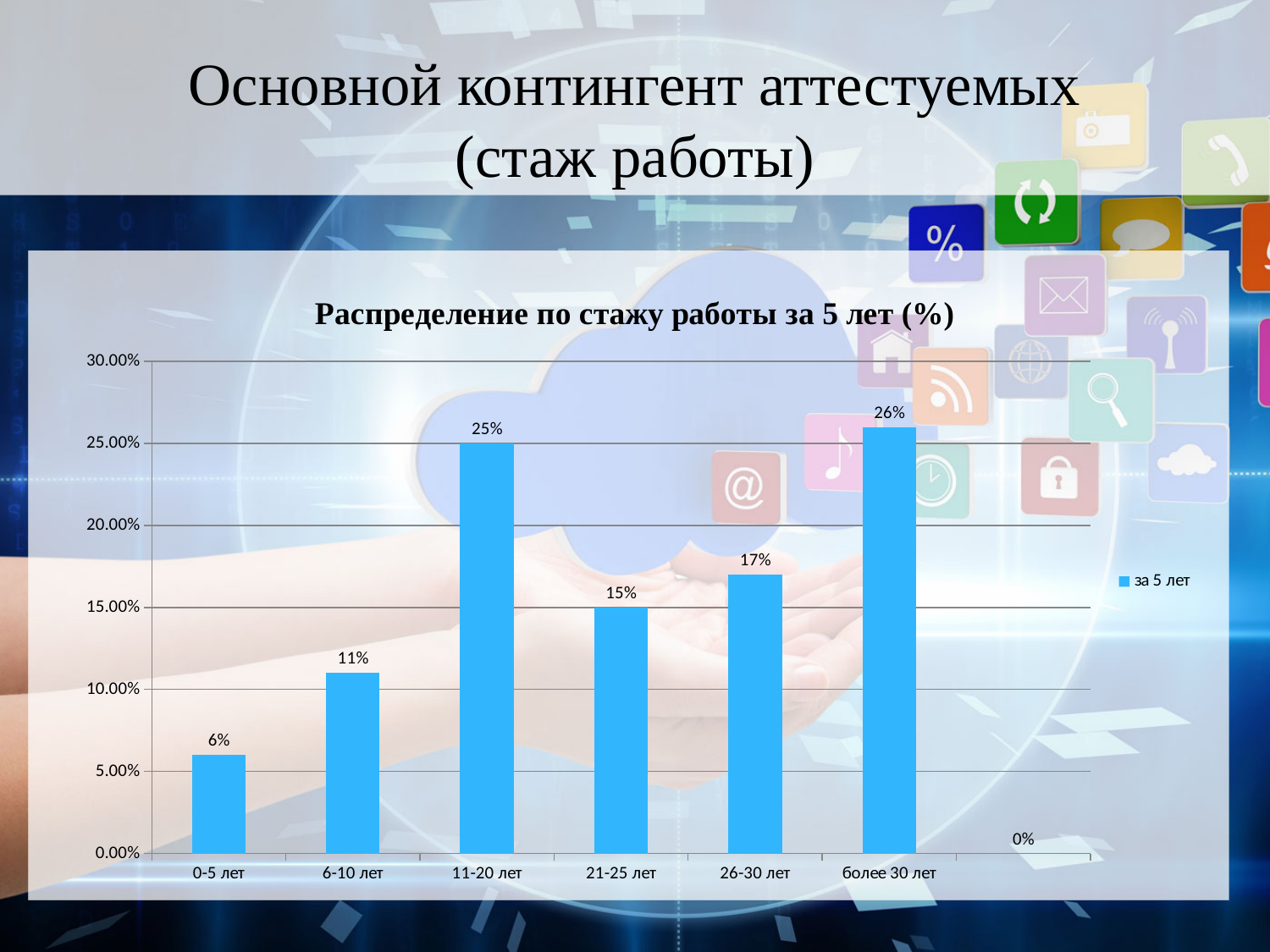
What is the value for более 30 лет? 26% What is the difference between the values for 6-10 лет and 0-5 лет? 5% What is the value for 26-30 лет? 17% What is the value for 11-20 лет? 25% Which is larger, the value for 21-25 лет or the value for 26-30 лет? 26-30 лет What is the difference between the values for 11-20 лет and 21-25 лет? 10% What kind of chart is shown? bar chart What is the title of the chart? Распределение по стажу работы за 5 лет (%) What is the value for 0-5 лет? 6% Which category has the highest value? более 30 лет How many series does the legend list? 1 Is the value for 6-10 лет greater or less than 10.00%? greater